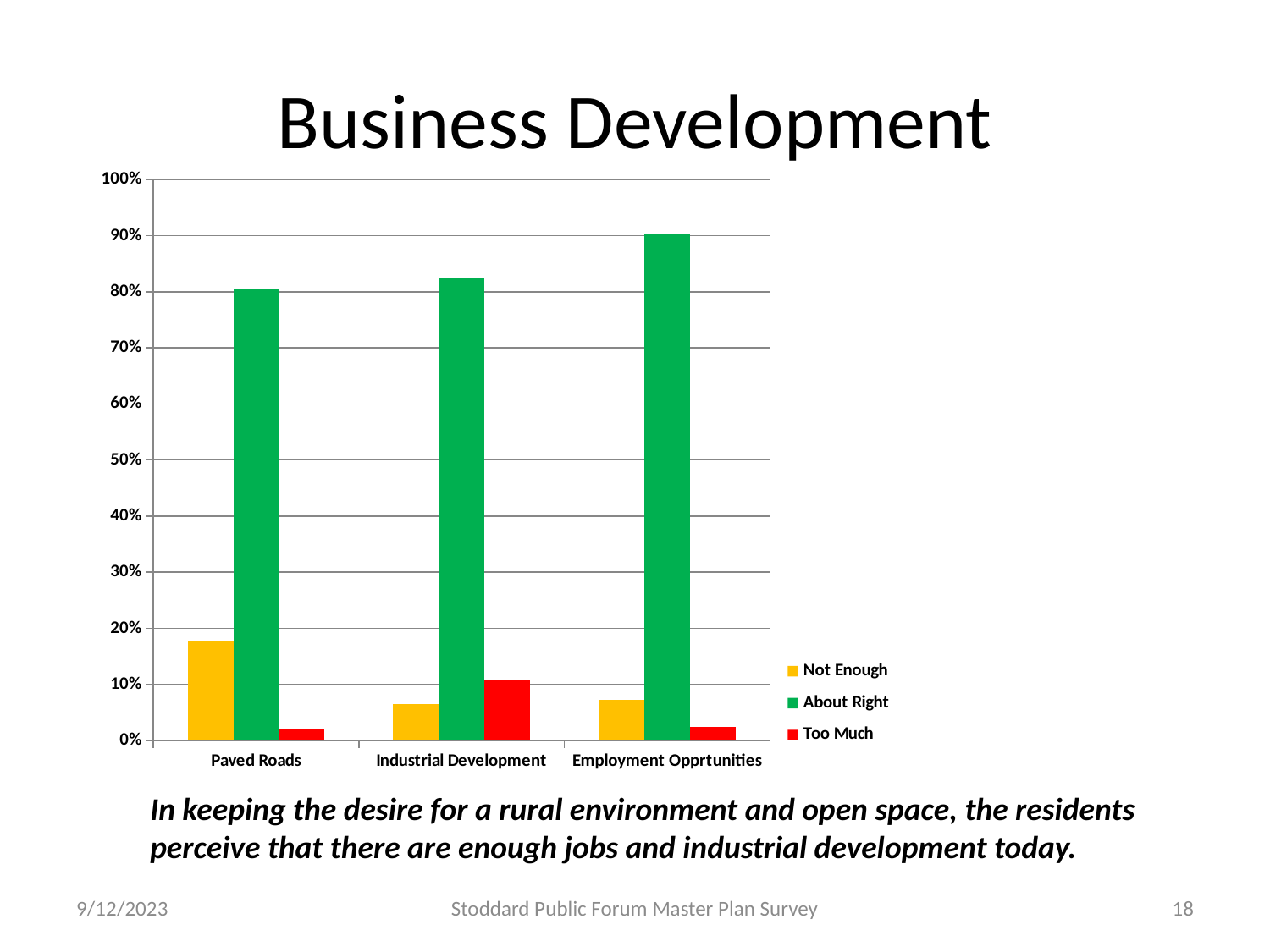
What kind of chart is shown on the slide? bar chart Is the About Right value for Paved Roads greater or less than 70%? greater Is the Not Enough value for Paved Roads greater or less than 20%? less Which category has the highest Not Enough value? Paved Roads How many series does the legend list? 3 Which category has the highest About Right value? Employment Opprtunities How many categories are shown on the x axis? 3 Which is larger: the Not Enough value for Paved Roads or the Too Much value for Industrial Development? Not Enough value for Paved Roads What colour are the About Right bars? green Which category has the highest Too Much value? Industrial Development Is the About Right value for Employment Opprtunities greater or less than 80%? greater